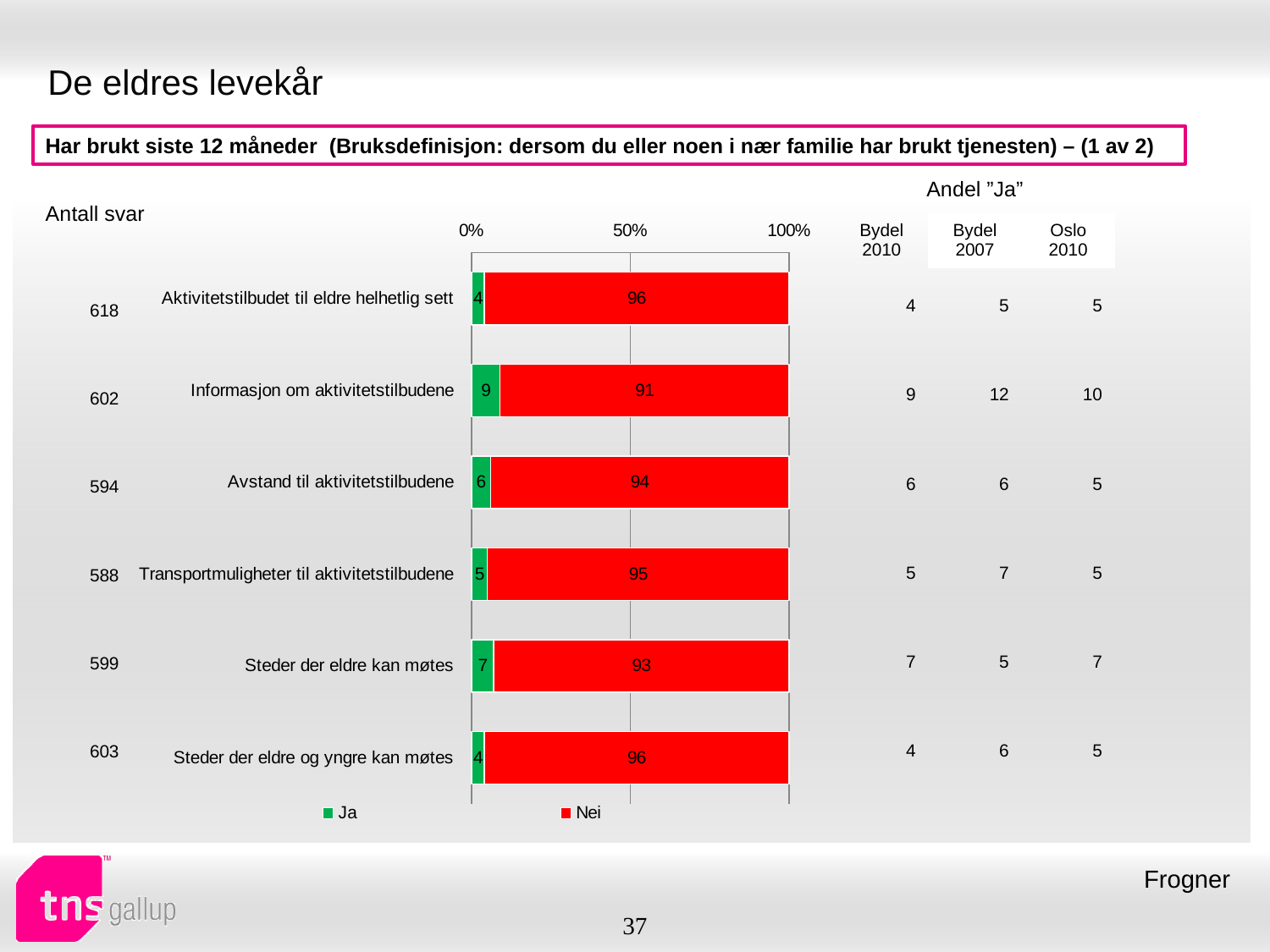
Which colour represents the "Nei" series in the chart? Red Which category has the highest "Ja" value? Informasjon om aktivitetstilbudene How many series does the chart legend list? 2 What is the "Nei" value for "Avstand til aktivitetstilbudene"? 94 Which is larger: the "Ja" value for "Steder der eldre kan møtes" or the "Ja" value for "Transportmuligheter til aktivitetstilbudene"? Steder der eldre kan møtes What is the "Nei" value for "Informasjon om aktivitetstilbudene"? 91 How many categories are plotted in the chart? 6 Which category has the lowest "Nei" value? Informasjon om aktivitetstilbudene What kind of chart is shown on the slide? Stacked bar chart What is the difference between the "Nei" values for "Aktivitetstilbudet til eldre helhetlig sett" and "Informasjon om aktivitetstilbudene"? 5 What is the "Ja" value for "Steder der eldre kan møtes"? 7 What is the total of the stacked bar for "Avstand til aktivitetstilbudene"? 100